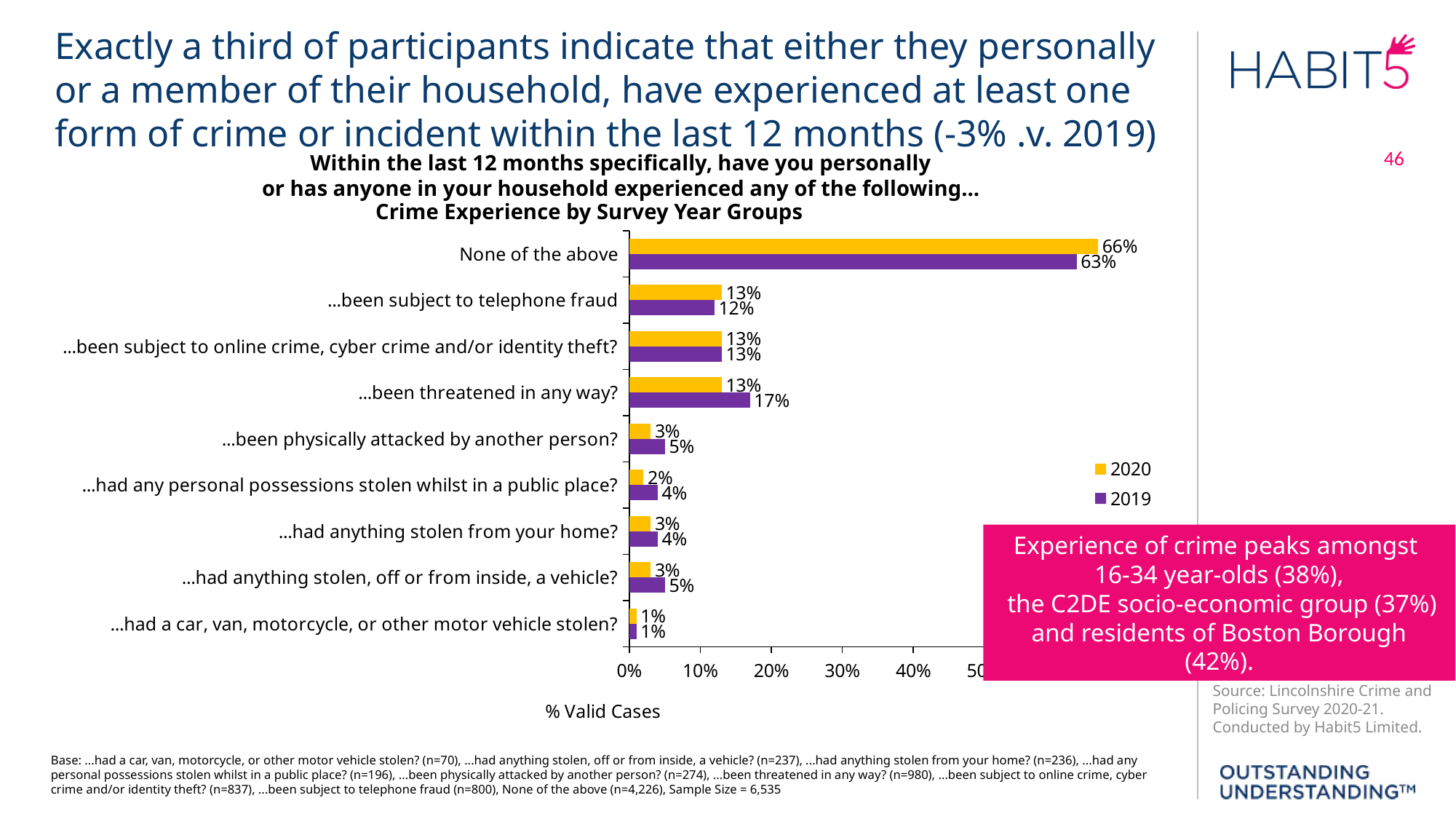
Which category has the lowest 2020 value? ...had a car, van, motorcycle, or other motor vehicle stolen? Which category has the highest 2019 value? None of the above What is the 2019 value for "...had any personal possessions stolen whilst in a public place?"? 4% How many categories are shown on the chart? 9 What kind of chart is shown on the slide? Bar chart What is the 2020 value for "None of the above"? 66% How many series does the legend list? 2 Which is larger for "...been physically attacked by another person?": the 2020 value or the 2019 value? 2019 What is the difference between the 2020 and 2019 values for "None of the above"? 3% What is the 2020 value for "...been subject to telephone fraud"? 13% What is the difference between the 2019 and 2020 values for "...been threatened in any way?"? 4% What is the 2019 value for "...been threatened in any way?"? 17%